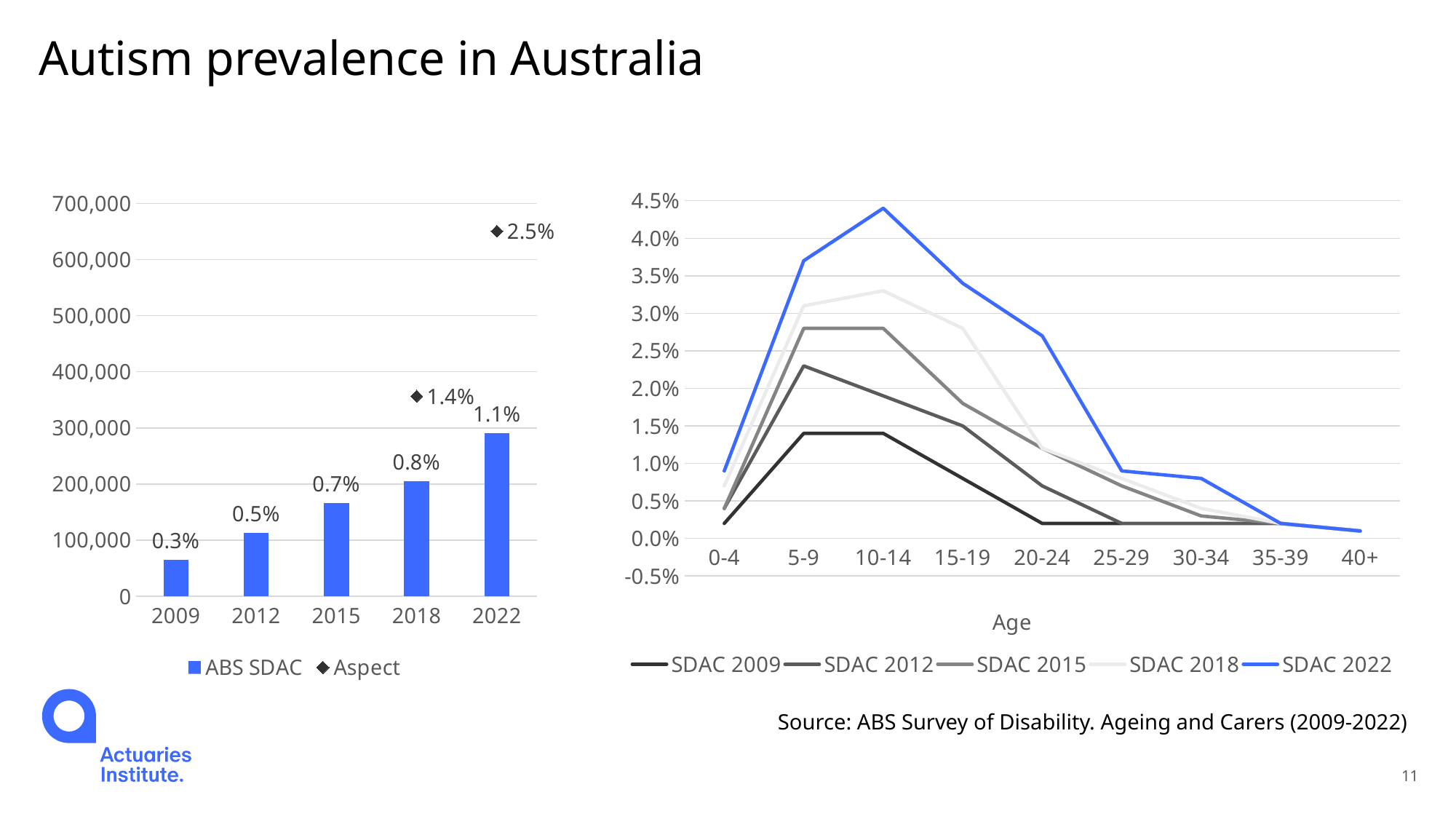
On the right chart, is the SDAC 2022 value for the 10-14 age group greater or less than 4.0%? greater On the left chart, what is the Aspect value shown for 2022? 2.5% On the left chart, do the ABS SDAC bars rise or fall from 2009 to 2022? rise On the left chart, how many years are shown on the x axis? 5 On the left chart, what is the difference between the Aspect value and the ABS SDAC percentage for 2022? 1.4 percentage points On the left chart, is the ABS SDAC bar for 2009 greater or less than 100,000? less What kind of chart is the right-hand chart? line chart On the left chart, what percentage label is shown on the ABS SDAC bar for 2009? 0.3% On the left chart, what is the Aspect value shown for 2018? 1.4% On the left chart, what percentage label is shown on the ABS SDAC bar for 2022? 1.1% On the right chart, which age group has the highest value for SDAC 2022? 10-14 On the right chart, how many series does the legend list? 5